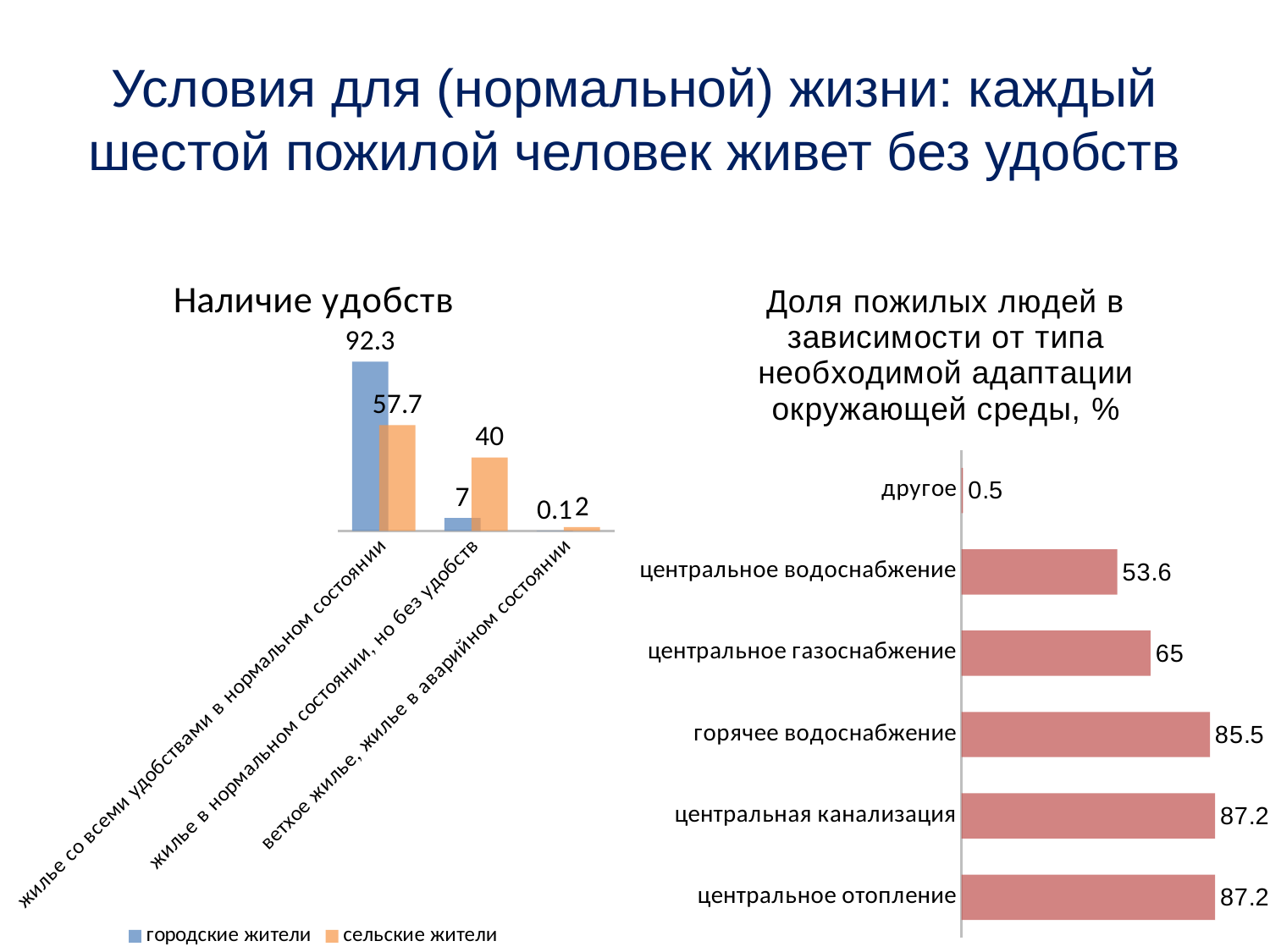
In the right-hand chart 'Доля пожилых людей в зависимости от типа необходимой адаптации окружающей среды, %', what is the difference between 'горячее водоснабжение' and 'центральное водоснабжение'? 31.9 In the chart 'Наличие удобств', what is the value for городские жители in the category 'жилье со всеми удобствами в нормальном состоянии'? 92.3 In the right-hand chart 'Доля пожилых людей в зависимости от типа необходимой адаптации окружающей среды, %', what is the value for 'центральное газоснабжение'? 65 What type of chart is 'Наличие удобств'? bar chart In the right-hand chart 'Доля пожилых людей в зависимости от типа необходимой адаптации окружающей среды, %', which category has the lowest value? другое How many series does the legend of the chart 'Наличие удобств' list? 2 In the chart 'Наличие удобств', what is the difference between городские жители and сельские жители in the category 'жилье со всеми удобствами в нормальном состоянии'? 34.6 In the right-hand chart 'Доля пожилых людей в зависимости от типа необходимой адаптации окружающей среды, %', which is larger: 'центральная канализация' or 'центральное газоснабжение'? центральная канализация In the chart 'Наличие удобств', what is the value for сельские жители in the category 'жилье в нормальном состоянии, но без удобств'? 40 In the right-hand chart 'Доля пожилых людей в зависимости от типа необходимой адаптации окружающей среды, %', how many categories are shown? 6 In the chart 'Наличие удобств', what is the value for городские жители in the category 'ветхое жилье, жилье в аварийном состоянии'? 0.1 In the chart 'Наличие удобств', which series has the larger value in the category 'жилье в нормальном состоянии, но без удобств'? сельские жители